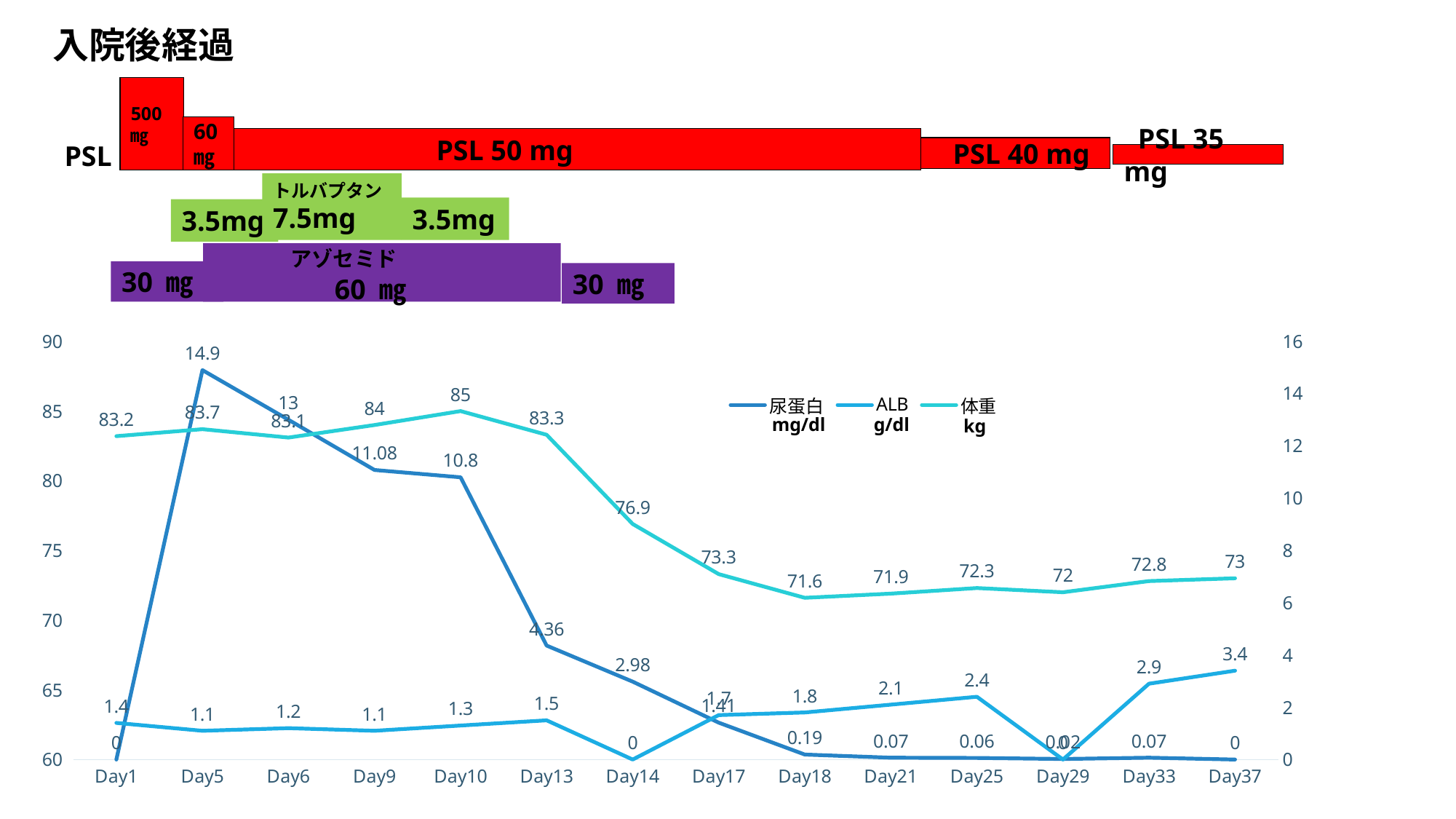
What is the 尿蛋白 value at Day5? 14.9 Does 体重 rise or fall from Day13 to Day18? fall Which is larger, the 尿蛋白 value at Day9 or at Day13? Day9 How many series does the chart legend list? 3 What kind of chart is shown on the slide? line chart How many day points are shown on the x axis of the chart? 14 What is the difference between the 体重 value at Day1 and at Day37? 10.2 What unit is shown under the 体重 legend entry? kg What is the 体重 value at Day10? 85 On which day is 体重 highest? Day10 What is the ALB value at Day37? 3.4 On which day is 尿蛋白 highest? Day5